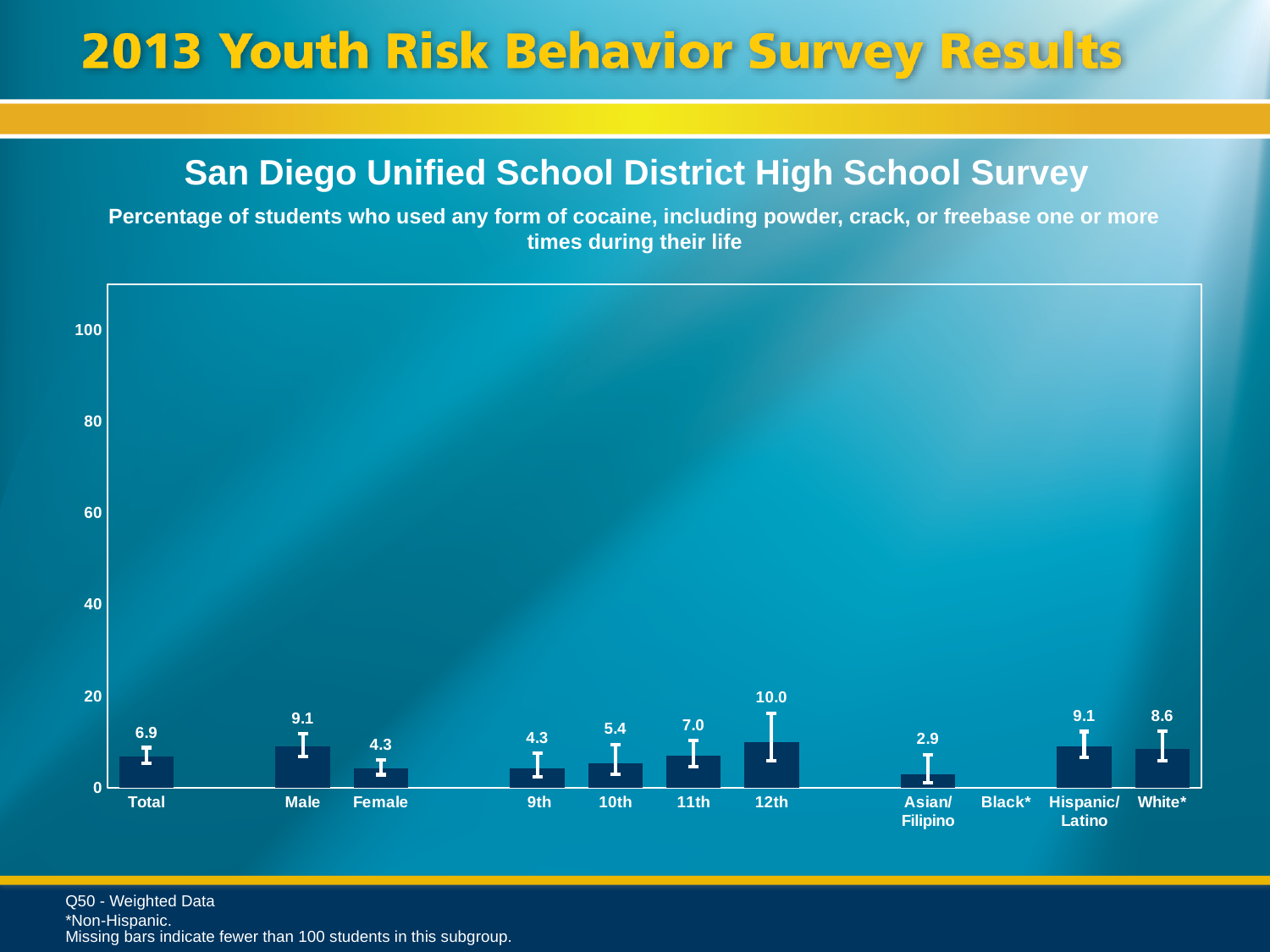
What is the value for Male? 9.1 What kind of chart is this? bar chart Which is larger, the value for 10th grade or 11th grade? 11th Do the values rise or fall from 9th grade to 12th grade? rise What is the difference between the Male and Female values? 4.8 Which category has the highest value? 12th What is the value for Total? 6.9 Which category has the lowest value among those with bars? Asian/Filipino Is the value for 12th grade greater or less than 20? less What is the value for Asian/Filipino? 2.9 What is the value for 12th grade? 10.0 Which category has no bar shown? Black*